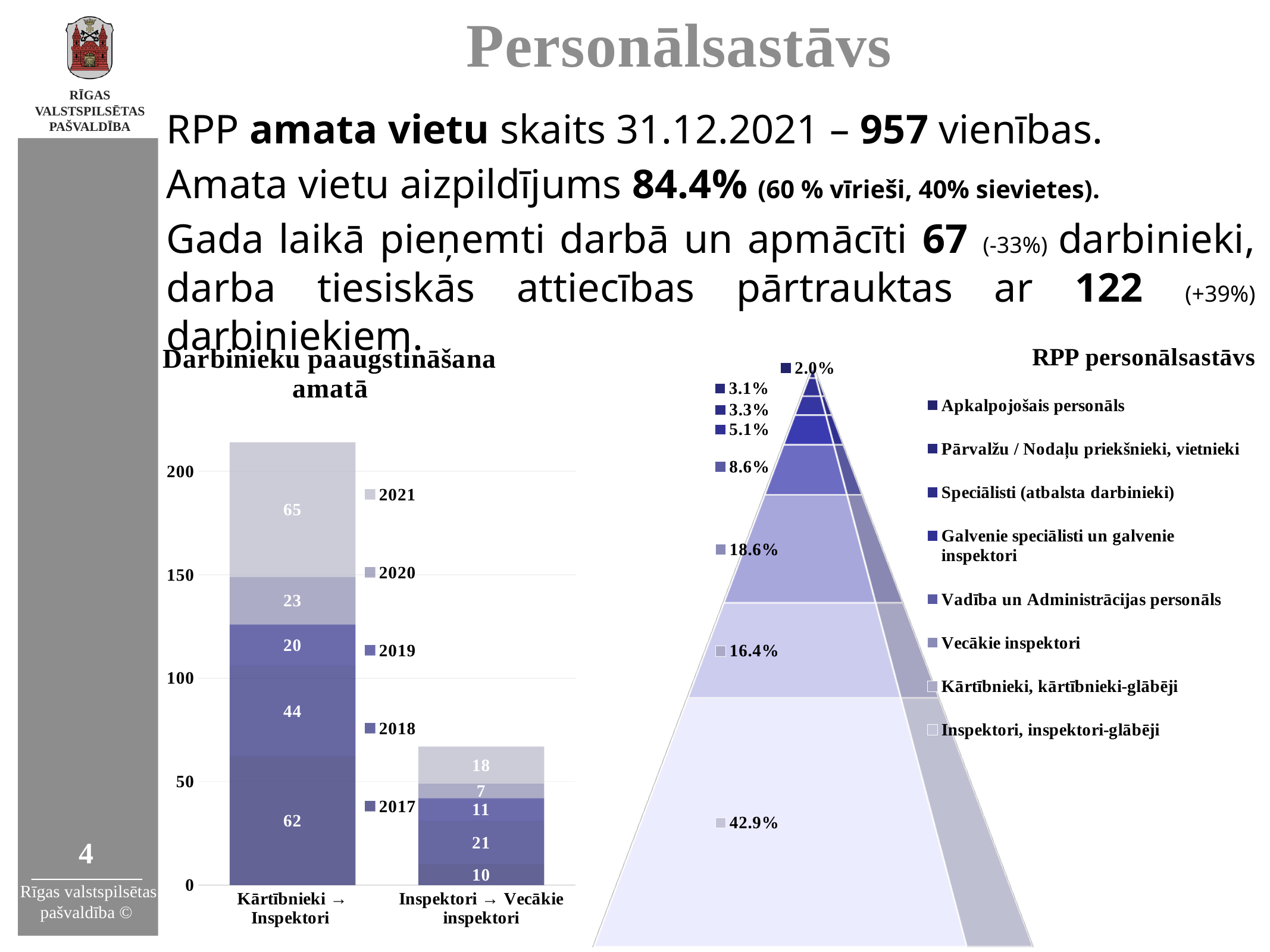
What kind of chart is 'Darbinieku paaugstināšana amatā'? Stacked bar chart How many series does the legend of the 'Darbinieku paaugstināšana amatā' chart list? 5 In the 'Darbinieku paaugstināšana amatā' chart, what is the difference between the 2021 and 2020 values for Kārtībnieki → Inspektori? 42 In the 'Darbinieku paaugstināšana amatā' chart, what is the total of the stacked bar for Inspektori → Vecākie inspektori? 67 In the 'Darbinieku paaugstināšana amatā' chart, which year has the lowest value for Inspektori → Vecākie inspektori? 2020 In the 'RPP personālsastāvs' chart, what is the largest percentage shown? 42.9% In the 'Darbinieku paaugstināšana amatā' chart, what is the 2018 value for Inspektori → Vecākie inspektori? 21 In the 'Darbinieku paaugstināšana amatā' chart, what is the 2017 value for Kārtībnieki → Inspektori? 62 In the 'Darbinieku paaugstināšana amatā' chart, what is the total of the stacked bar for Kārtībnieki → Inspektori? 214 In the 'Darbinieku paaugstināšana amatā' chart, what is the 2021 value for Kārtībnieki → Inspektori? 65 In the 'RPP personālsastāvs' chart, what is the smallest percentage shown? 2.0% How many categories does the legend of the 'RPP personālsastāvs' chart list? 8